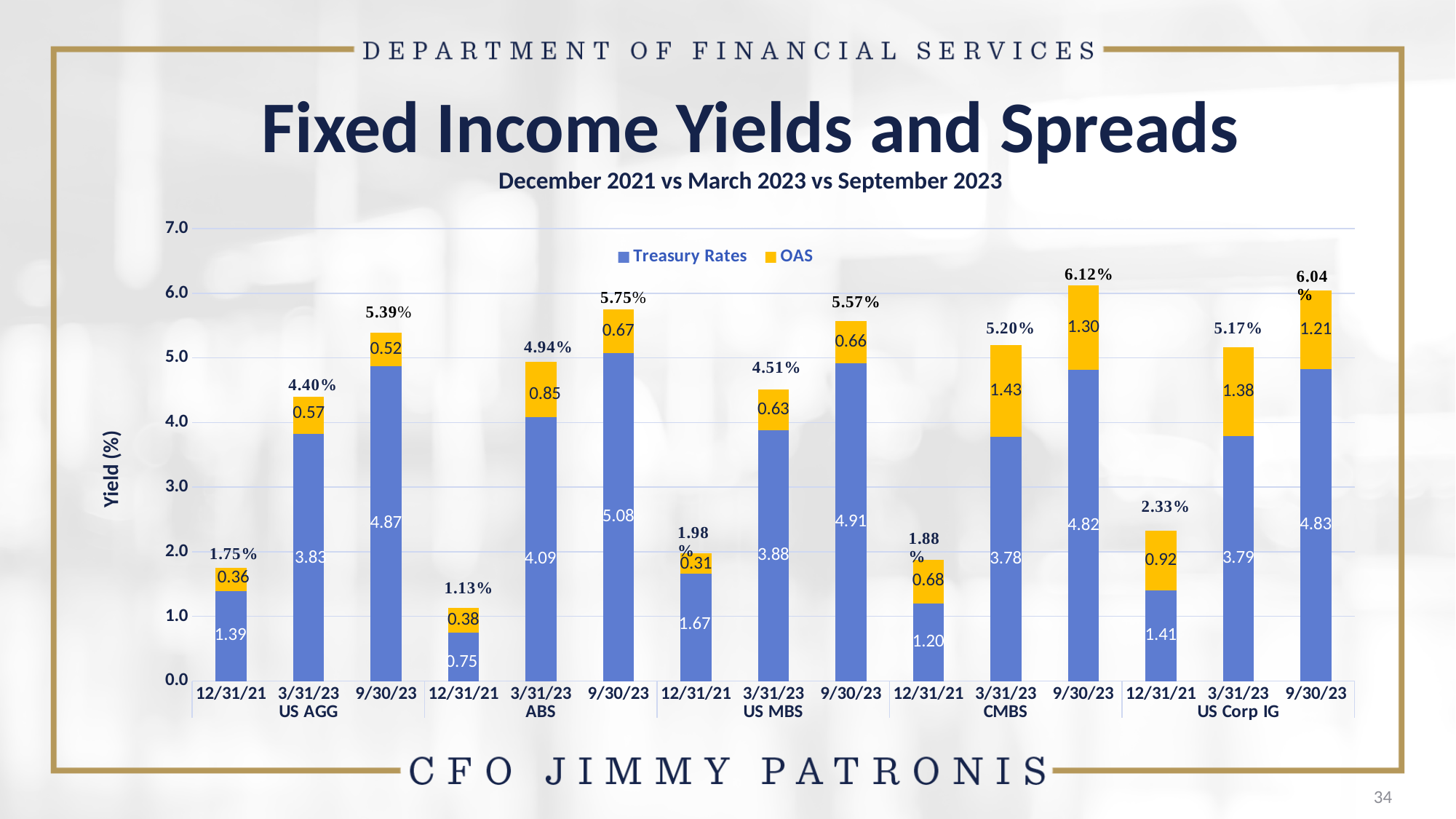
Which is larger, the Treasury Rates value for ABS on 9/30/23 or for US MBS on 9/30/23? ABS on 9/30/23 (5.08) What is the total yield labeled for US Corp IG on 9/30/23? 6.04% Which bar has the highest total yield? CMBS 9/30/23 (6.12%) What is the Treasury Rates value for US AGG on 9/30/23? 4.87 What is the difference between the OAS for US Corp IG on 3/31/23 and the OAS for US AGG on 3/31/23? 0.81 How many bars are plotted in the chart? 15 How many series does the legend list? 2 Is the total yield for US MBS on 3/31/23 greater or less than 4.0? greater Within the CMBS group, do the total yields rise or fall from 12/31/21 to 9/30/23? Rise What is the OAS value for CMBS on 3/31/23? 1.43 What kind of chart is shown on the slide? Stacked bar chart Which bar has the lowest total yield? ABS 12/31/21 (1.13%)